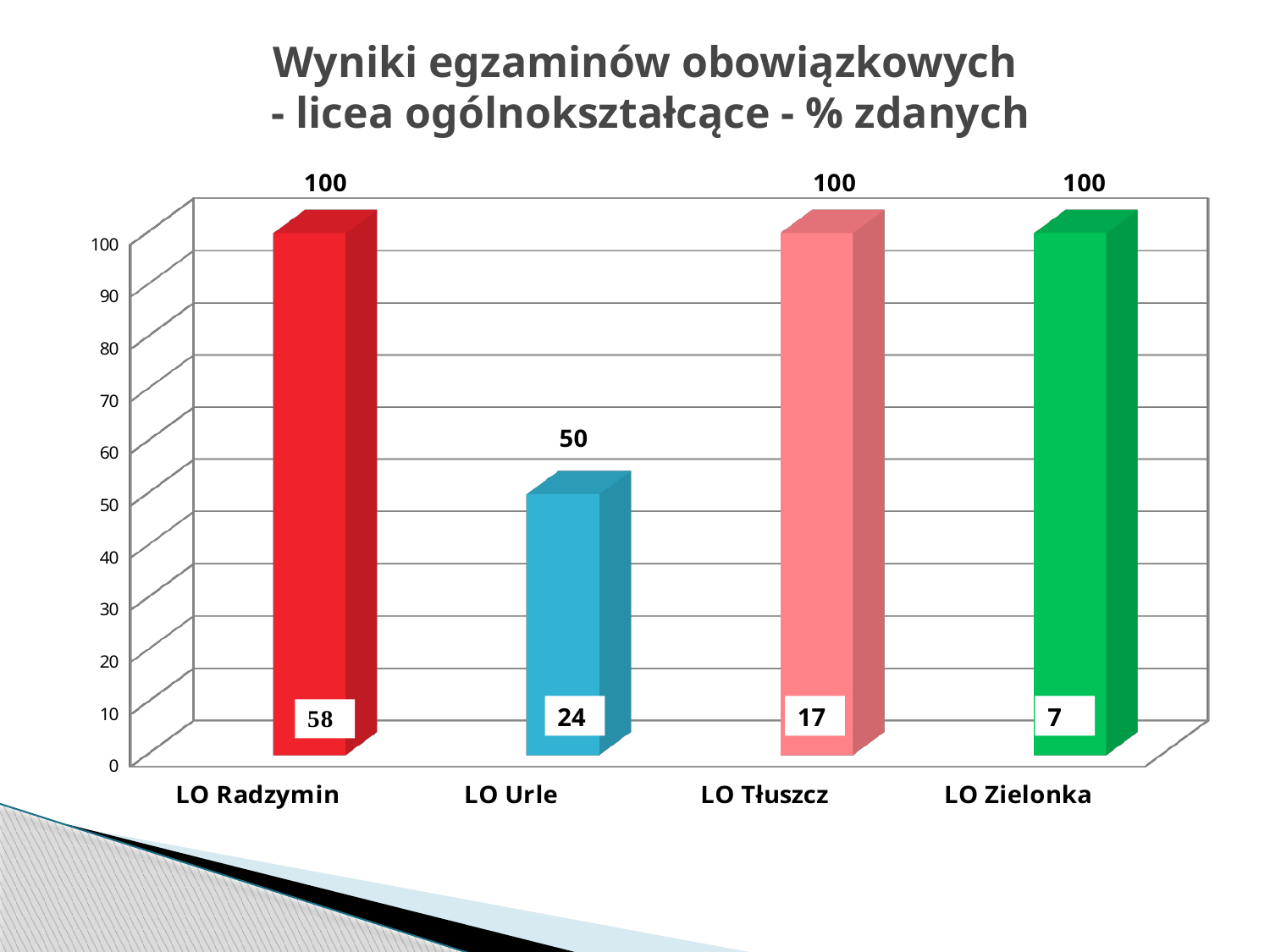
Is the value for LO Urle greater or less than 60? less What is the value shown for LO Radzymin? 100 How many categories have a value of 100? 3 What is the difference between the values for LO Radzymin and LO Urle? 50 Which category has the lowest value? LO Urle What is the title of the chart? Wyniki egzaminów obowiązkowych - licea ogólnokształcące - % zdanych What number is printed inside the bar for LO Zielonka? 7 What is the value shown for LO Urle? 50 How many categories are shown on the x axis? 4 What is the value shown for LO Zielonka? 100 What kind of chart is shown on the slide? bar chart Which has the larger value, LO Tłuszcz or LO Urle? LO Tłuszcz